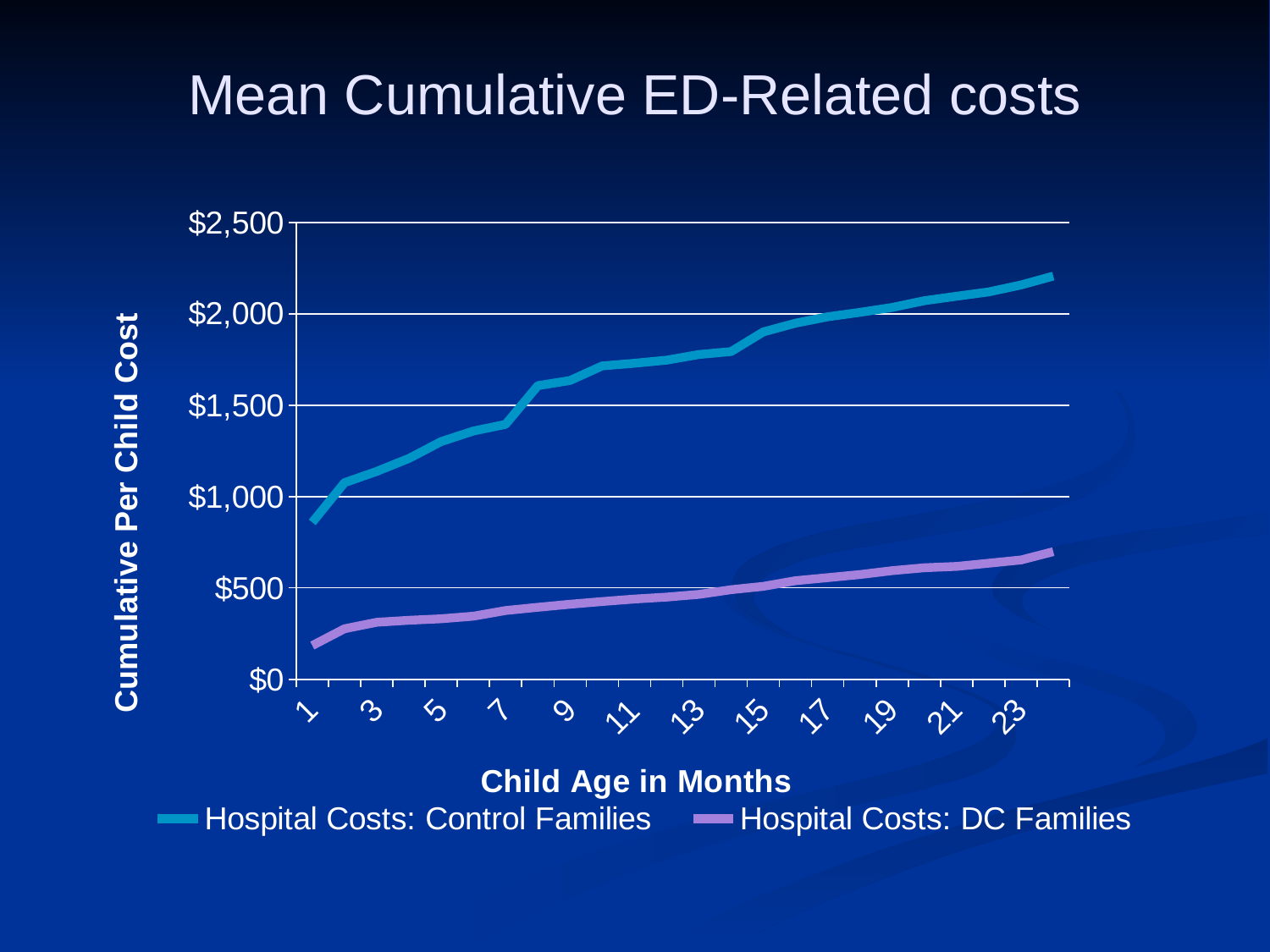
Do the values for Hospital Costs: DC Families rise or fall as child age increases? Rise What kind of chart is shown on the slide? Line chart Is the value for Hospital Costs: Control Families at month 1 greater or less than $1,000? less What is the title of the chart? Mean Cumulative ED-Related costs Is the value for Hospital Costs: Control Families at month 23 greater or less than $2,000? greater Is the value for Hospital Costs: DC Families at month 23 greater or less than $500? greater What is the label on the x axis of the chart? Child Age in Months Do the values for Hospital Costs: Control Families rise or fall as child age increases? Rise How many series does the legend list? 2 At month 13, which series has the higher value: Hospital Costs: Control Families or Hospital Costs: DC Families? Hospital Costs: Control Families